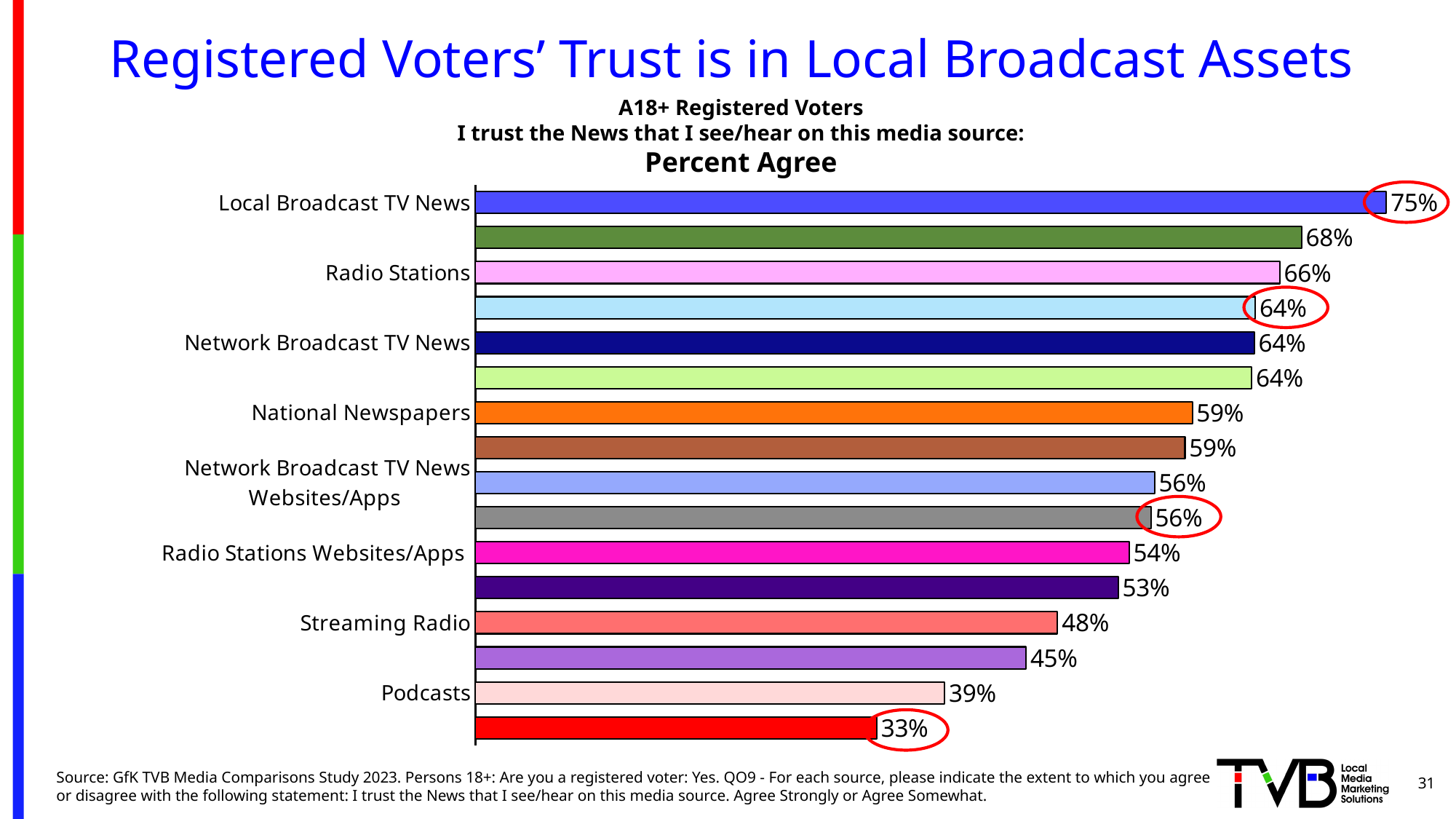
What is the lowest value shown on the chart? 33% How many bars are plotted on the chart? 16 What is the value for Radio Stations? 66% What is the difference in percentage points between Local Broadcast TV News and Network Broadcast TV News? 11 What is the value for Podcasts? 39% What is the value for Network Broadcast TV News? 64% What kind of chart is shown on the slide? Bar chart What is the value for National Newspapers? 59% Which media source has the highest percent agree? Local Broadcast TV News What is the value for Local Broadcast TV News? 75% Which is larger, the value for Radio Stations or the value for Streaming Radio? Radio Stations What is the value for Streaming Radio? 48%